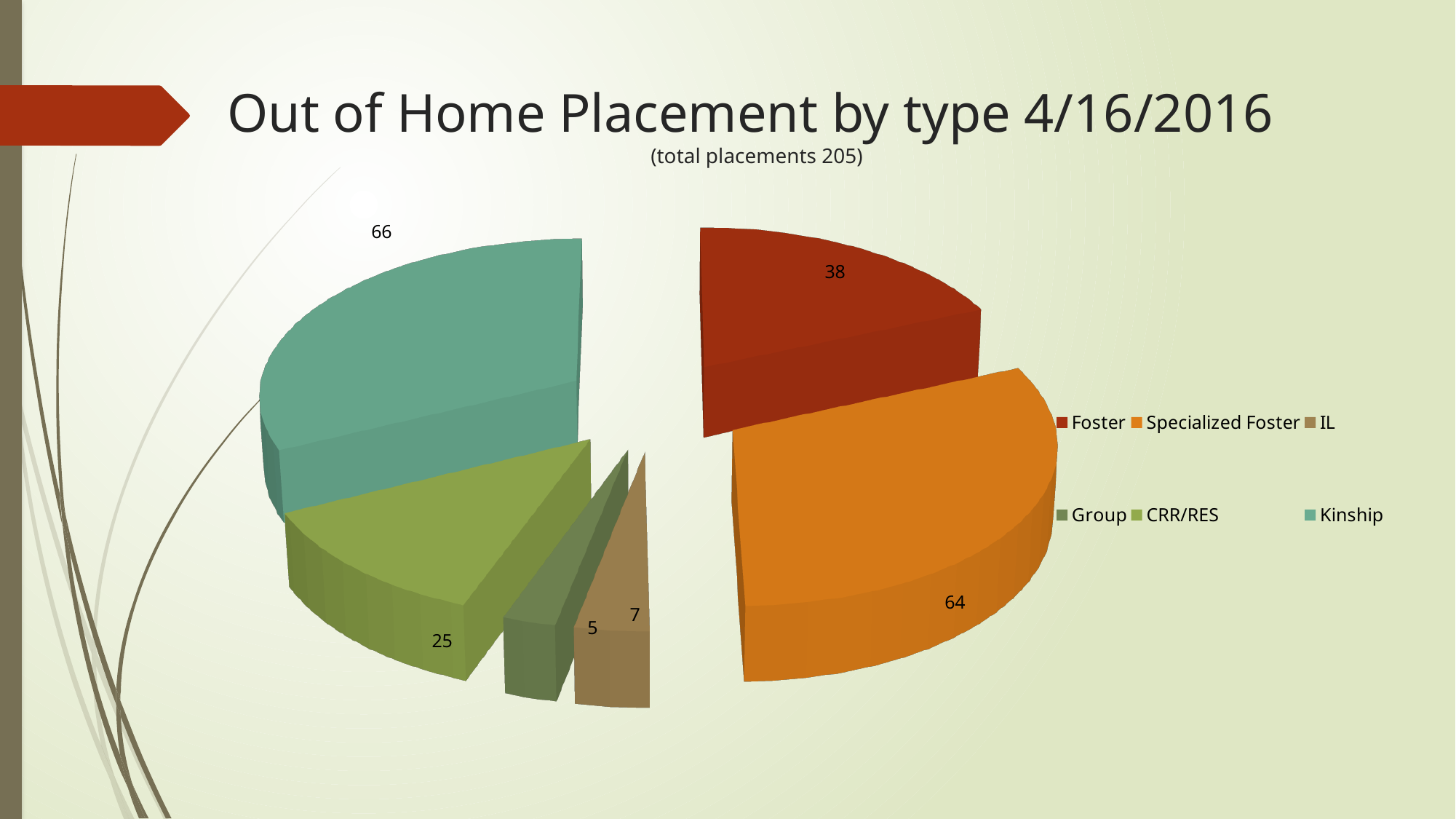
What is the value for Foster? 38 Which is larger, CRR/RES or Foster? Foster Which placement type has the largest value? Kinship What is the value for Specialized Foster? 64 How many placements are in the Kinship category? 66 What type of chart is shown on the slide? pie chart Which placement type has the smallest value? Group What is the difference between the Specialized Foster and Foster values? 26 What is the value for CRR/RES? 25 How many placement types are shown in the pie chart? 6 What is the total number of placements stated on the slide? 205 What is the value for IL? 7